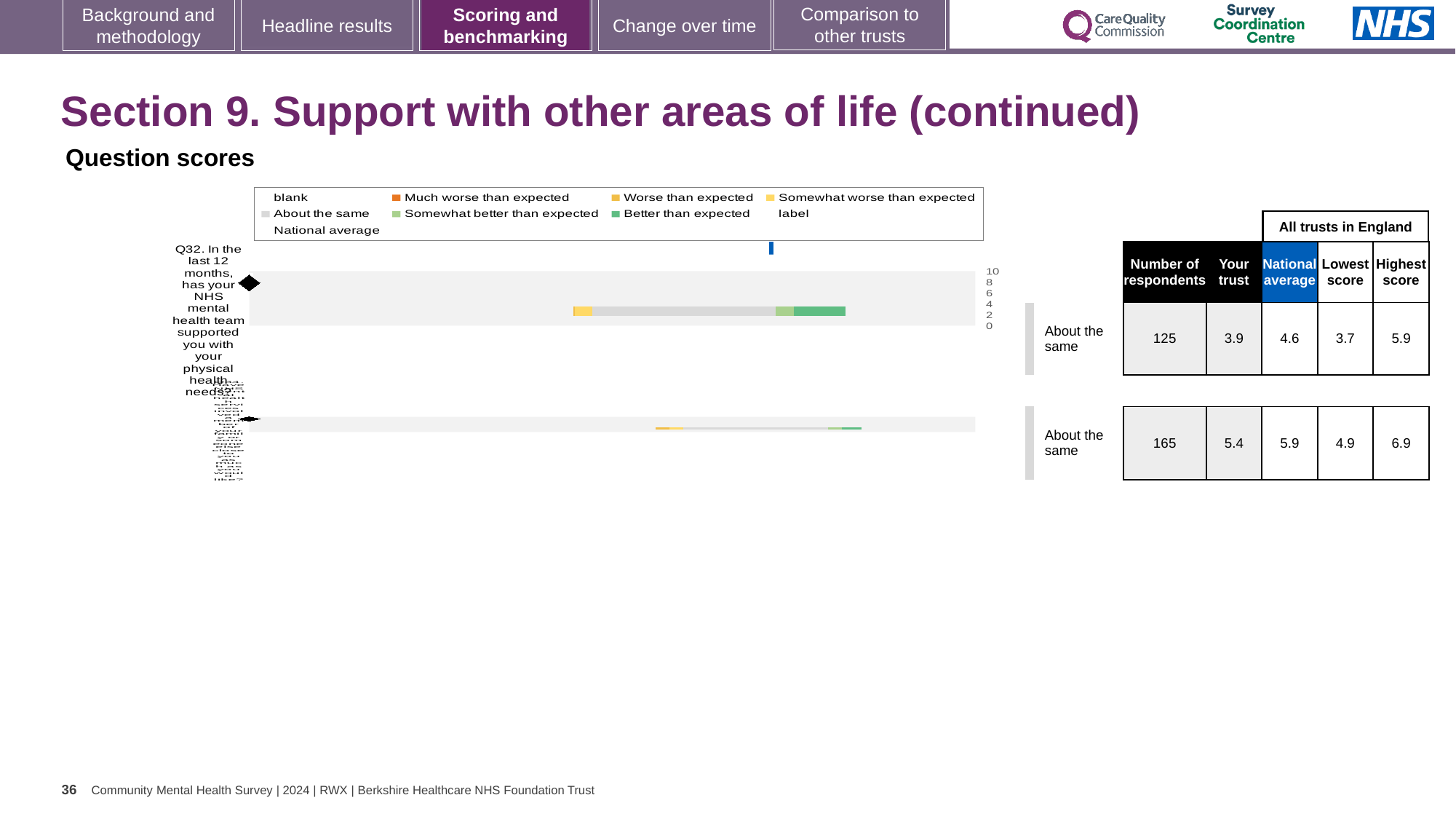
How many question rows (bars) does the chart show? 2 How many respondents answered Q32, according to the table beside the chart? 125 What is the highest score among all trusts in England for Q32? 5.9 What kind of chart is shown on the slide? bar chart According to the table beside the chart, what is the national average score for Q32? 4.6 In the chart legend, what does the blue marker represent? National average What benchmarking category is the trust's Q32 score placed in? About the same For Q32, which is larger: the 'Your trust' score or the national average? National average According to the table beside the chart, what is the 'Your trust' score for Q32 (support with physical health needs)? 3.9 For Q32, what is the difference between the highest score and the lowest score among all trusts in England? 2.2 What is the lowest score among all trusts in England for Q32? 3.7 What is the highest value shown on the chart's score axis? 10